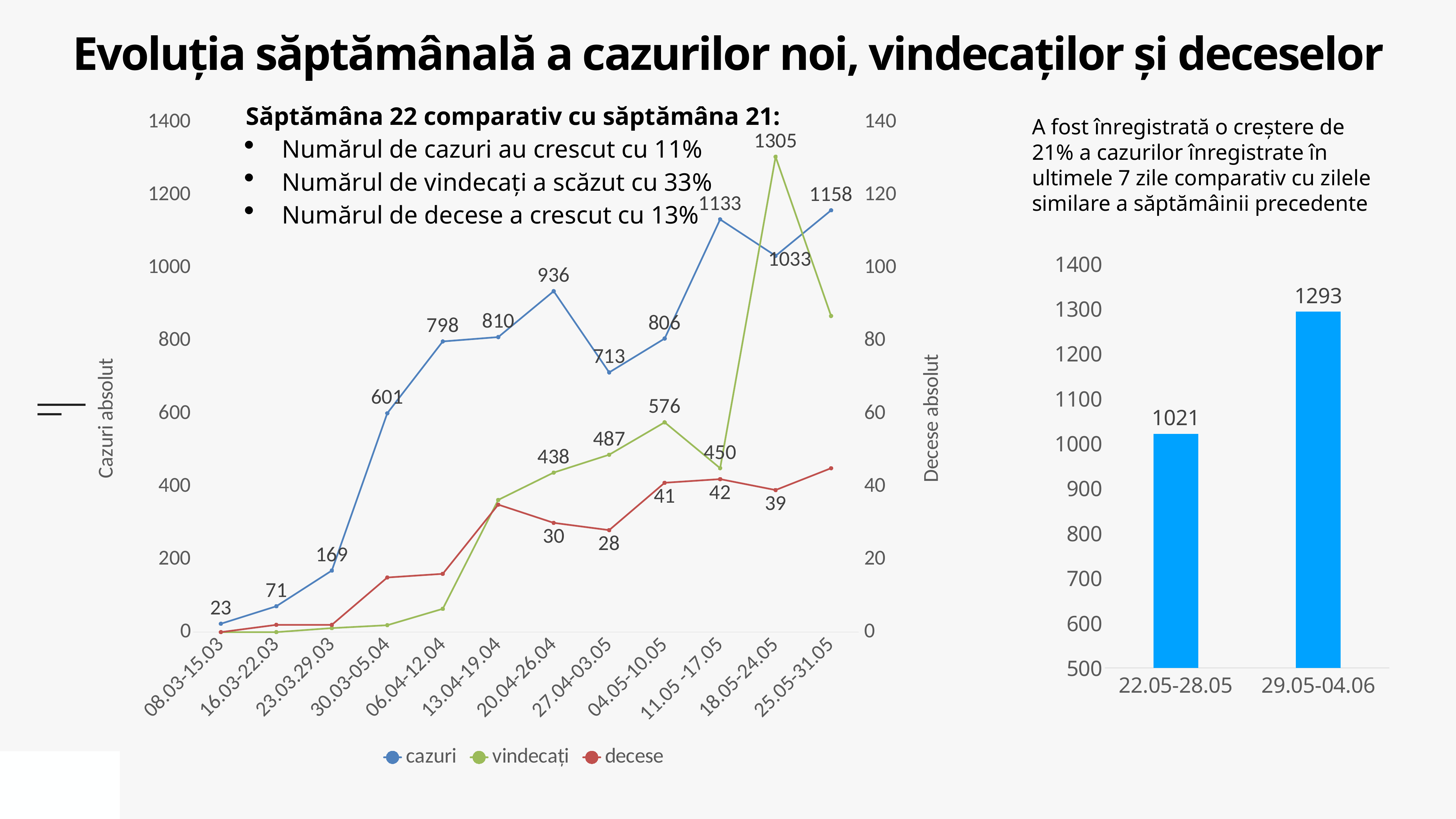
What kind of chart is the chart on the right of the slide? bar chart In the line chart on the left, which week has the lowest value of cazuri? 08.03-15.03 In the line chart on the left, what is the value of cazuri for the week 30.03-05.04? 601 In the line chart on the left, which week has more cazuri: 20.04-26.04 or 27.04-03.05? 20.04-26.04 How many series does the legend of the line chart on the left list? 3 How many weeks are shown on the x axis of the line chart on the left? 12 In the bar chart on the right, what is the difference between the value for 29.05-04.06 and the value for 22.05-28.05? 272 In the line chart on the left, what is the difference between cazuri in 25.05-31.05 and cazuri in 18.05-24.05? 125 In the line chart on the left, is the value of vindecați for 25.05-31.05 greater or less than 800? greater In the line chart on the left, which week has the highest value of cazuri? 25.05-31.05 In the line chart on the left, what is the value of decese for the week 27.04-03.05? 28 In the line chart on the left, what is the value of vindecați for the week 18.05-24.05? 1305